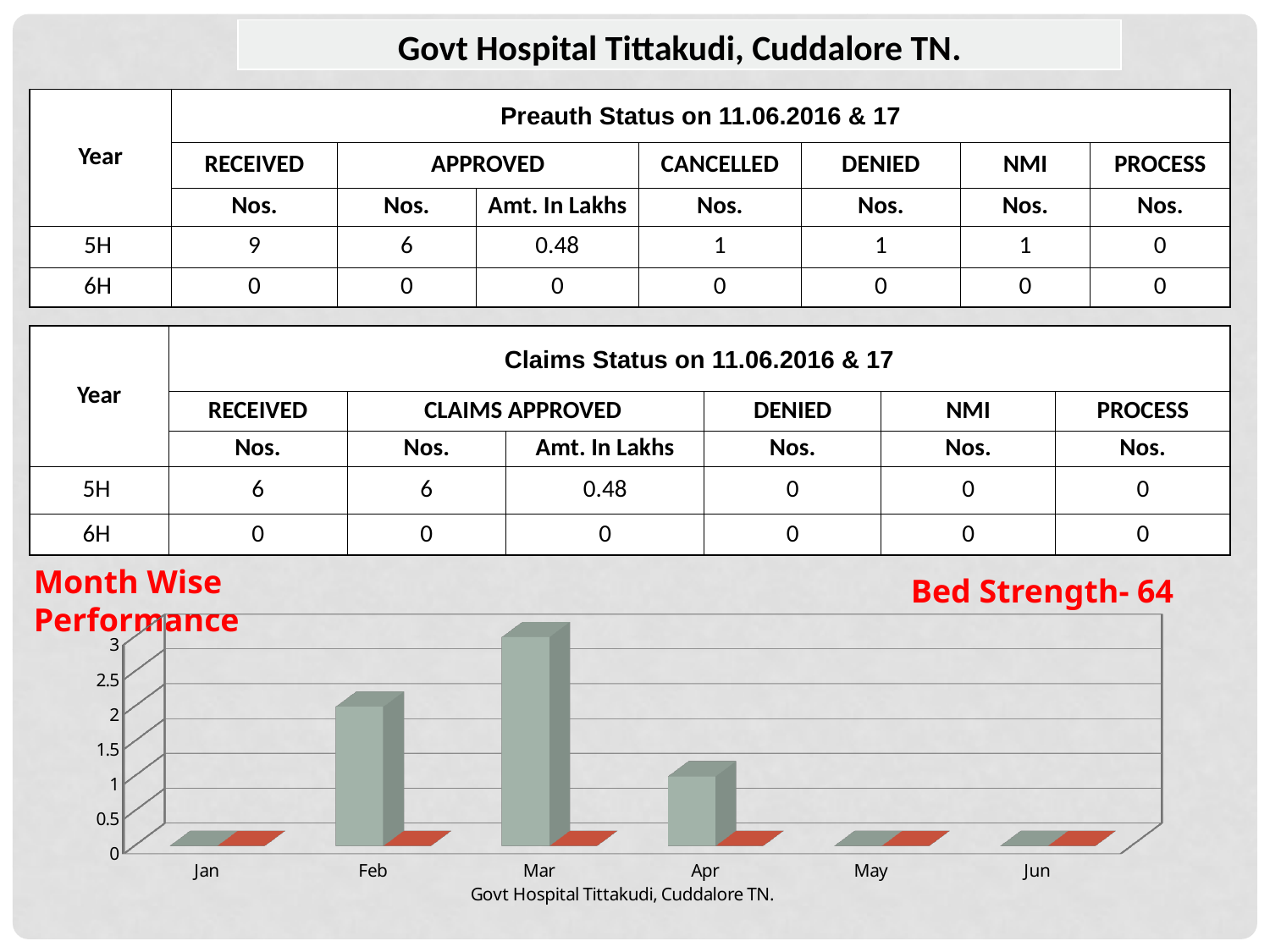
Which month has the tallest bar in the Month Wise Performance chart? Mar What is the value of the green bar for Mar in the Month Wise Performance chart? 3 In the Month Wise Performance chart, which month has the larger green bar, Feb or Apr? Feb What text appears below the x axis of the Month Wise Performance chart? Govt Hospital Tittakudi, Cuddalore TN. What kind of chart is shown at the bottom of the slide? bar chart In the Month Wise Performance chart, what is the difference between the green bar values for Mar and Apr? 2 What is the value of the green bar for Apr in the Month Wise Performance chart? 1 How many months are shown on the x axis of the Month Wise Performance chart? 6 What is the value of the green bar for Feb in the Month Wise Performance chart? 2 In the Month Wise Performance chart, do the green bar values rise or fall from Mar to Apr? fall In the Month Wise Performance chart, is the green bar for Mar greater or less than 2.5? greater What is the title shown above the bar chart on the slide? Month Wise Performance